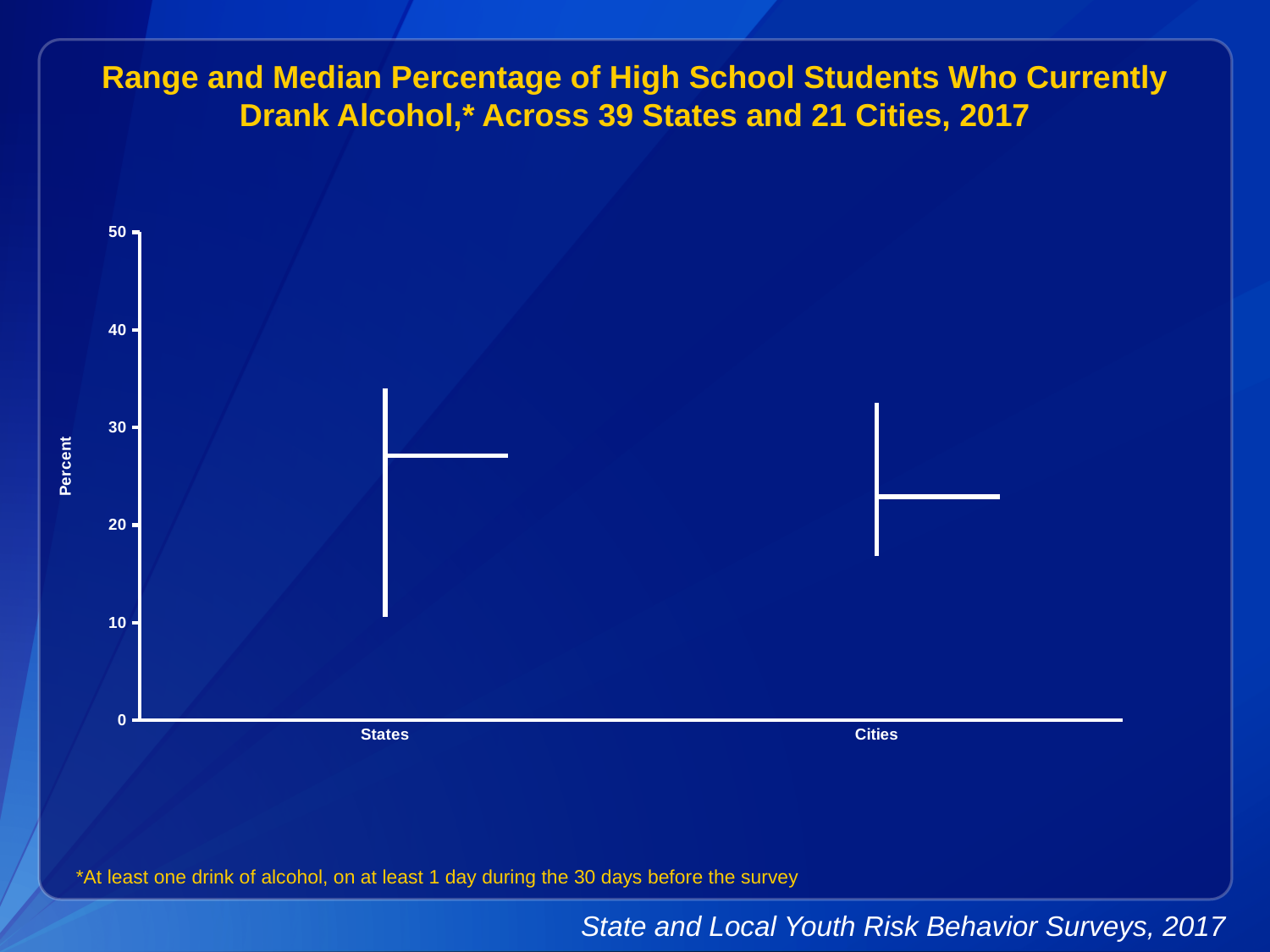
What is the label of the vertical axis? Percent Is the highest value in the range for States greater or less than 30? greater Which category has the higher median value, States or Cities? States Is the lowest value in the range for States greater or less than 20? less Is the median value for Cities greater or less than 30? less How many categories are shown on the x axis of the chart? 2 Which category has the lower bottom of its range, States or Cities? States What are the two categories shown on the x axis? States and Cities